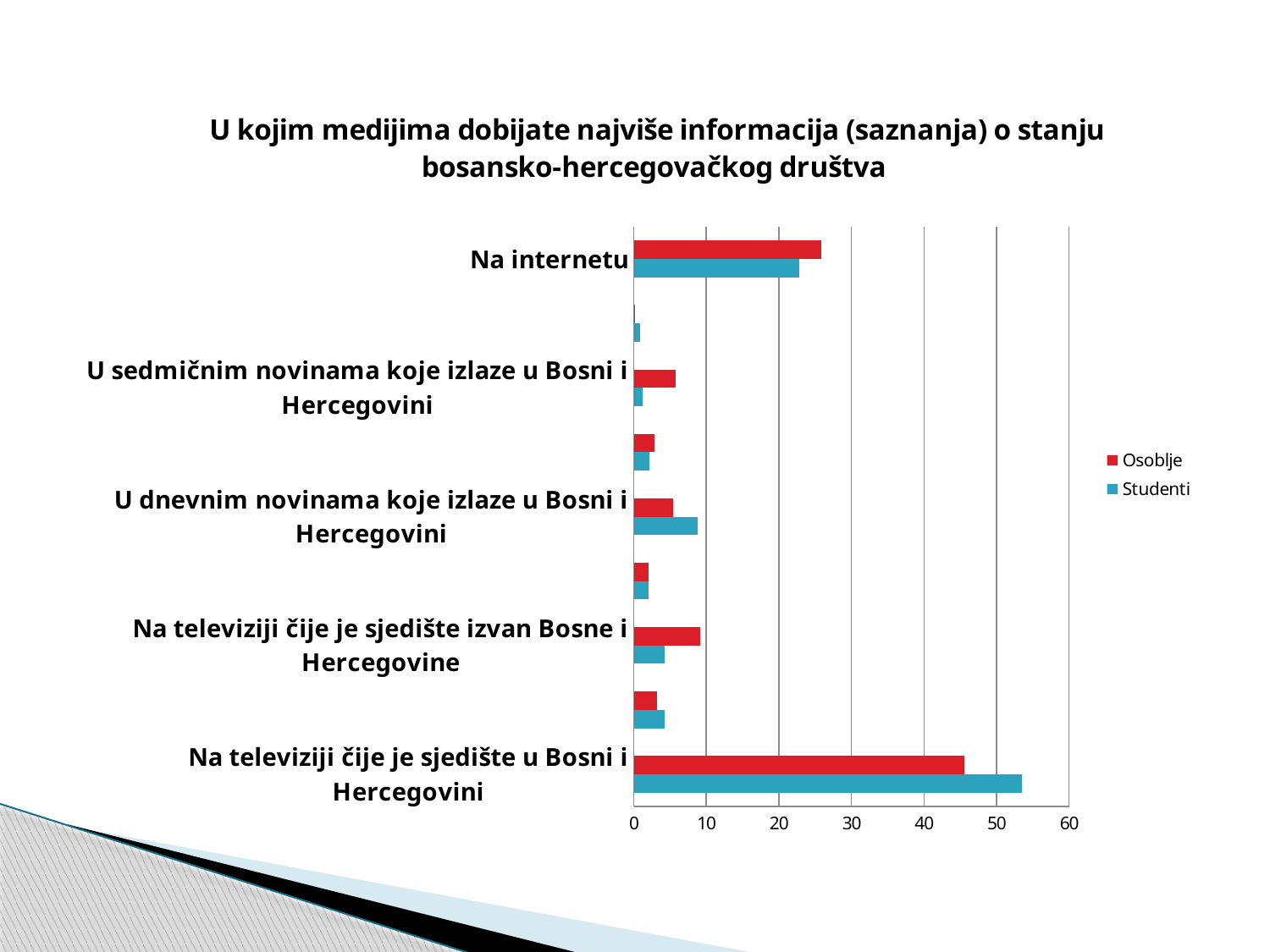
Is the Studenti value for 'Na televiziji čije je sjedište u Bosni i Hercegovini' greater or less than 50? greater What are the two series named in the legend? Osoblje and Studenti Which category has the highest value for Osoblje? Na televiziji čije je sjedište u Bosni i Hercegovini For 'Na televiziji čije je sjedište izvan Bosne i Hercegovine', which series has the larger value, Osoblje or Studenti? Osoblje How many series does the legend list? 2 Which category has the highest value for Studenti? Na televiziji čije je sjedište u Bosni i Hercegovini Is the Studenti value for 'U sedmičnim novinama koje izlaze u Bosni i Hercegovini' greater or less than 10? less What kind of chart is shown on the slide? Bar chart Which colour represents the Studenti series? Blue Is the Osoblje value for 'Na internetu' greater or less than 20? greater For 'Na televiziji čije je sjedište u Bosni i Hercegovini', which series has the larger value, Osoblje or Studenti? Studenti